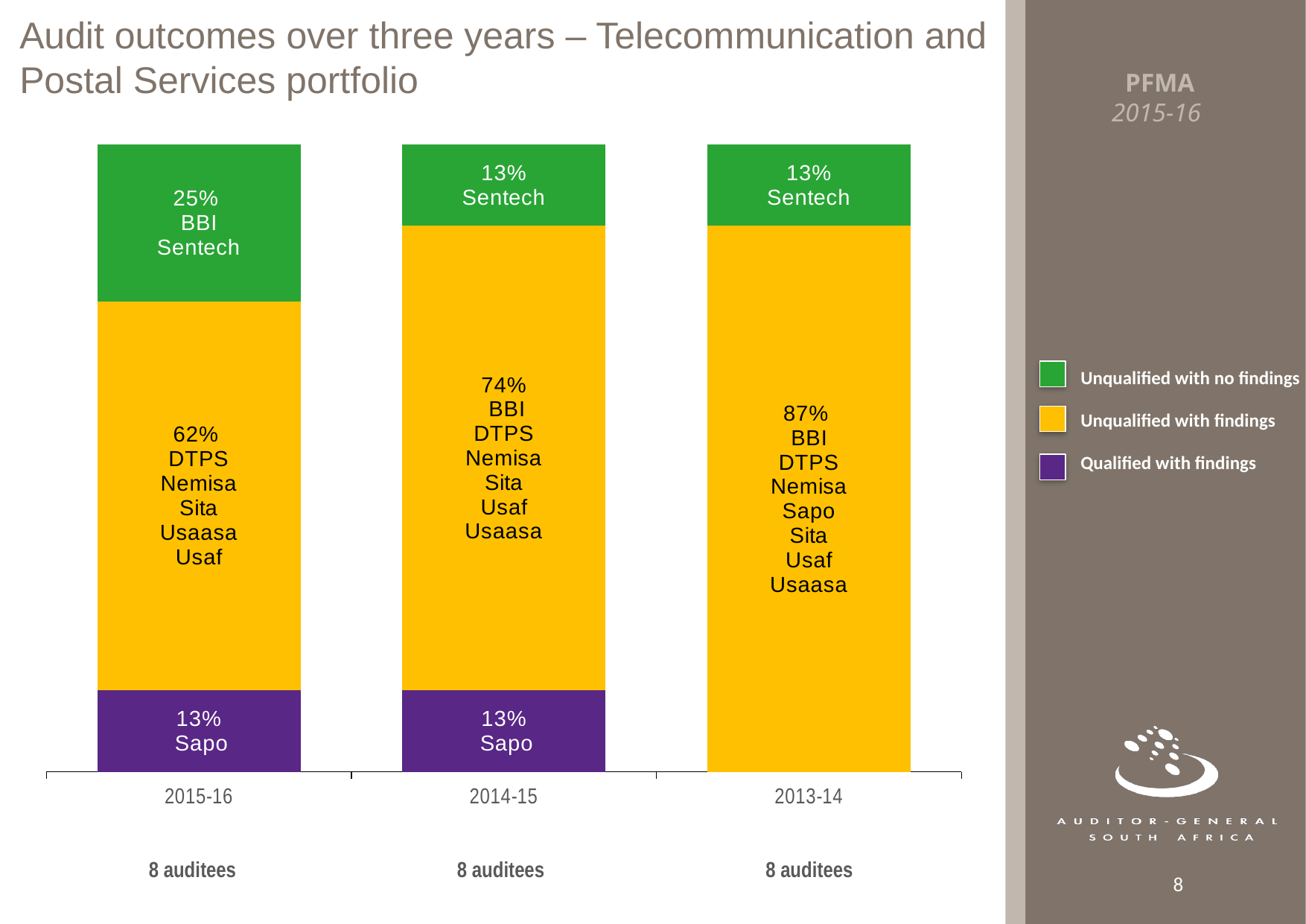
What is the value of the Unqualified with findings segment for 2015-16? 62% In which year is the Unqualified with no findings segment the largest? 2015-16 What is the value of the Unqualified with findings segment for 2013-14? 87% What kind of chart is shown on the slide? Stacked bar chart What is the value of the Qualified with findings segment for 2014-15? 13% How many series does the legend list? 3 What is the difference between the Unqualified with findings values for 2013-14 and 2015-16? 25 percentage points In which year is the Unqualified with findings segment the largest? 2013-14 What is the value of the Unqualified with no findings segment for 2015-16? 25% Which is larger: the Unqualified with no findings value for 2015-16 or for 2014-15? 2015-16 Which auditee is in the Qualified with findings segment for 2015-16? Sapo How many years are shown on the x axis? 3